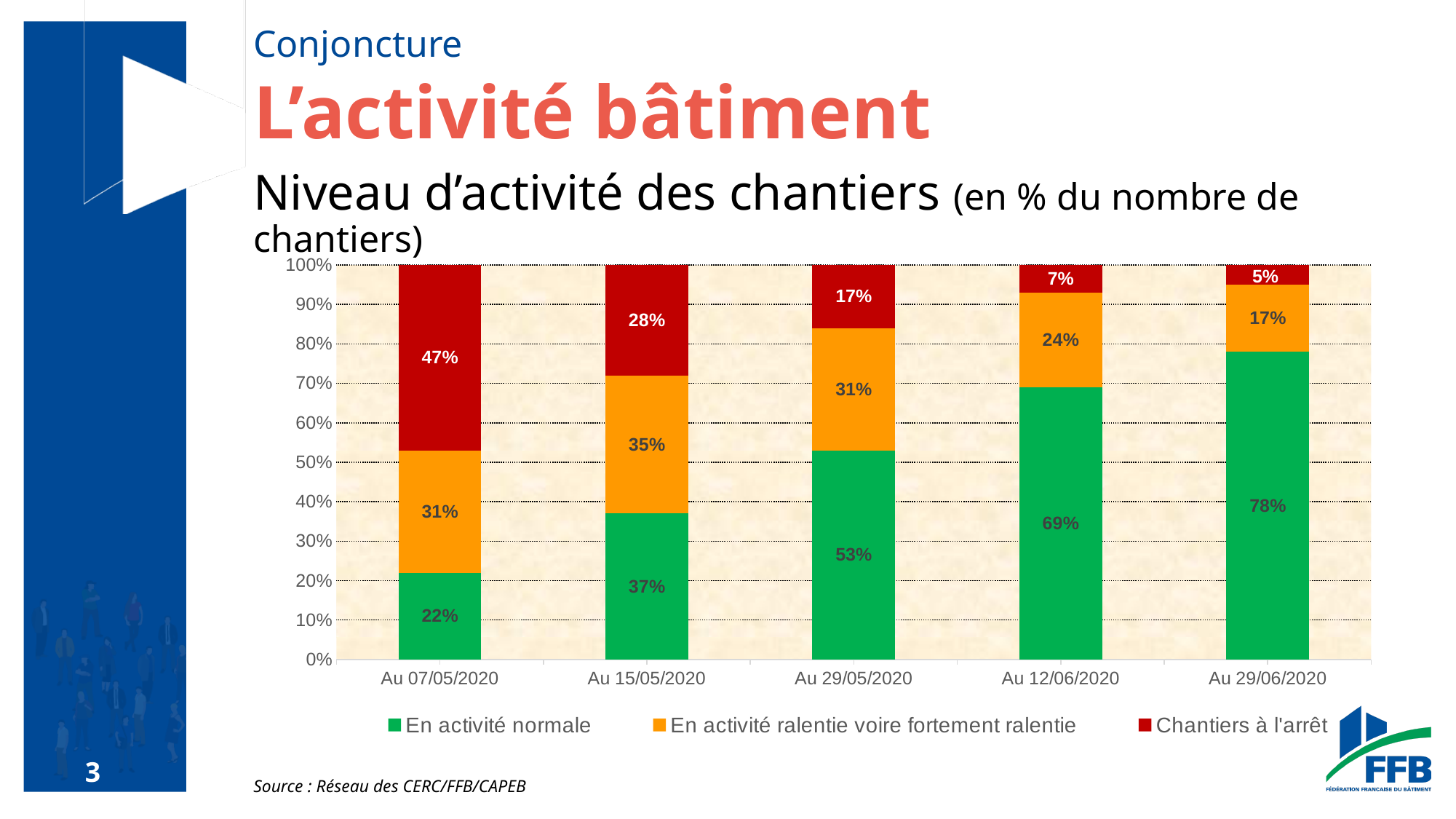
How many dates are shown on the x axis? 5 Which colour represents "Chantiers à l'arrêt" in the chart? Red How many series does the legend list? 3 Does the "Chantiers à l'arrêt" share rise or fall from Au 07/05/2020 to Au 29/06/2020? Fall At which date is the "En activité normale" share highest? Au 29/06/2020 What is the value for "En activité normale" at Au 07/05/2020? 22% What is the value for "En activité ralentie voire fortement ralentie" at Au 12/06/2020? 24% What is the difference between the "En activité normale" values at Au 29/06/2020 and Au 07/05/2020? 56% What kind of chart is shown? Stacked bar chart Which is larger at Au 29/05/2020: "En activité normale" or "En activité ralentie voire fortement ralentie"? En activité normale At which date is the "Chantiers à l'arrêt" share lowest? Au 29/06/2020 What is the value for "Chantiers à l'arrêt" at Au 15/05/2020? 28%